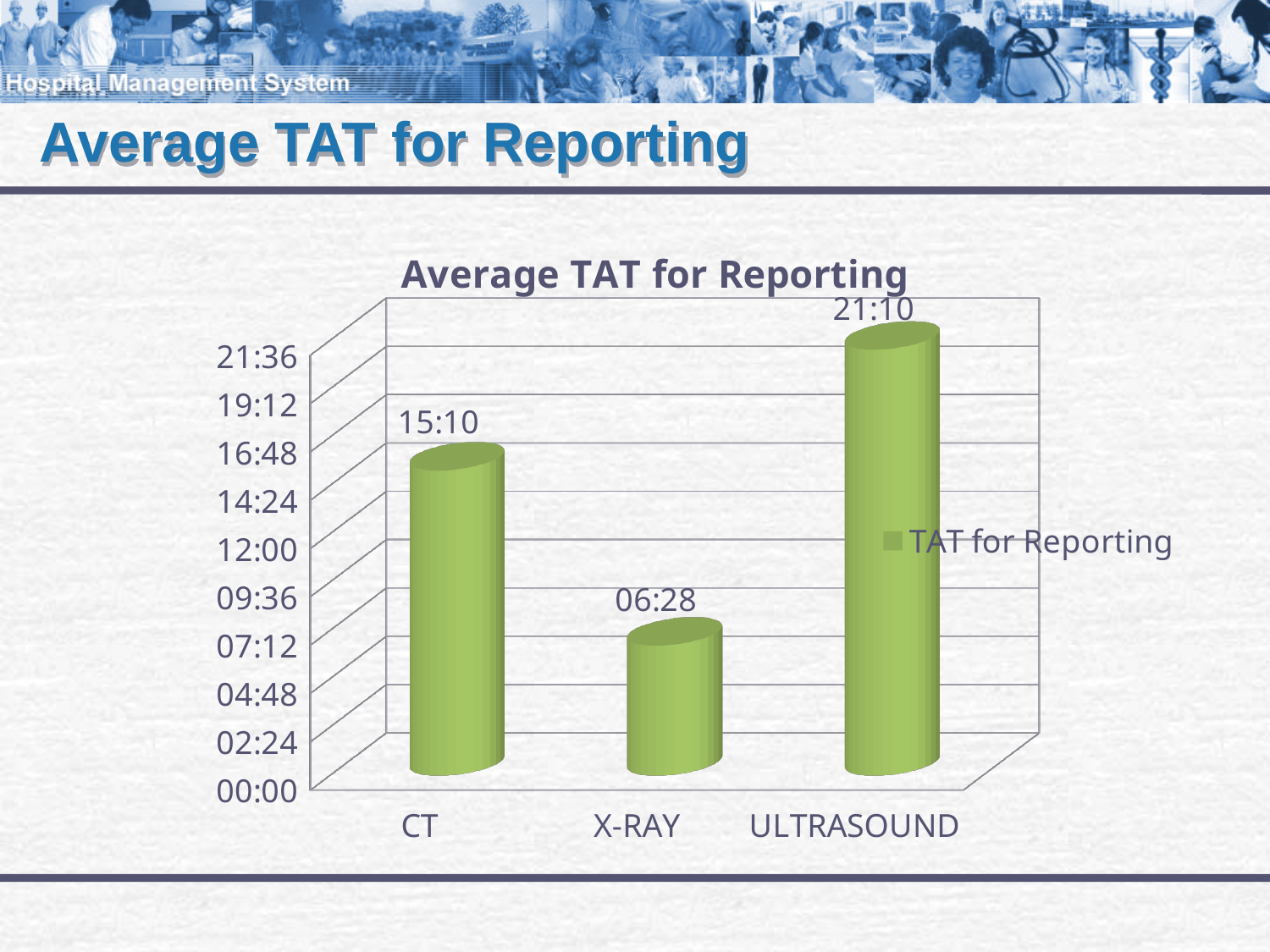
Is the value for ULTRASOUND greater or less than 19:12? greater What kind of chart is shown on the slide? Bar chart Is the value for X-RAY greater or less than 07:12? less How many categories are shown on the x axis of the chart? 3 What is the legend entry shown in the chart? TAT for Reporting Which category has the lowest average TAT for reporting? X-RAY How many series does the chart legend list? 1 Which category has the highest average TAT for reporting? ULTRASOUND What is the value for ULTRASOUND in the Average TAT for Reporting chart? 21:10 What is the value for CT in the Average TAT for Reporting chart? 15:10 Which has a larger value, CT or X-RAY? CT What is the value for X-RAY in the Average TAT for Reporting chart? 06:28